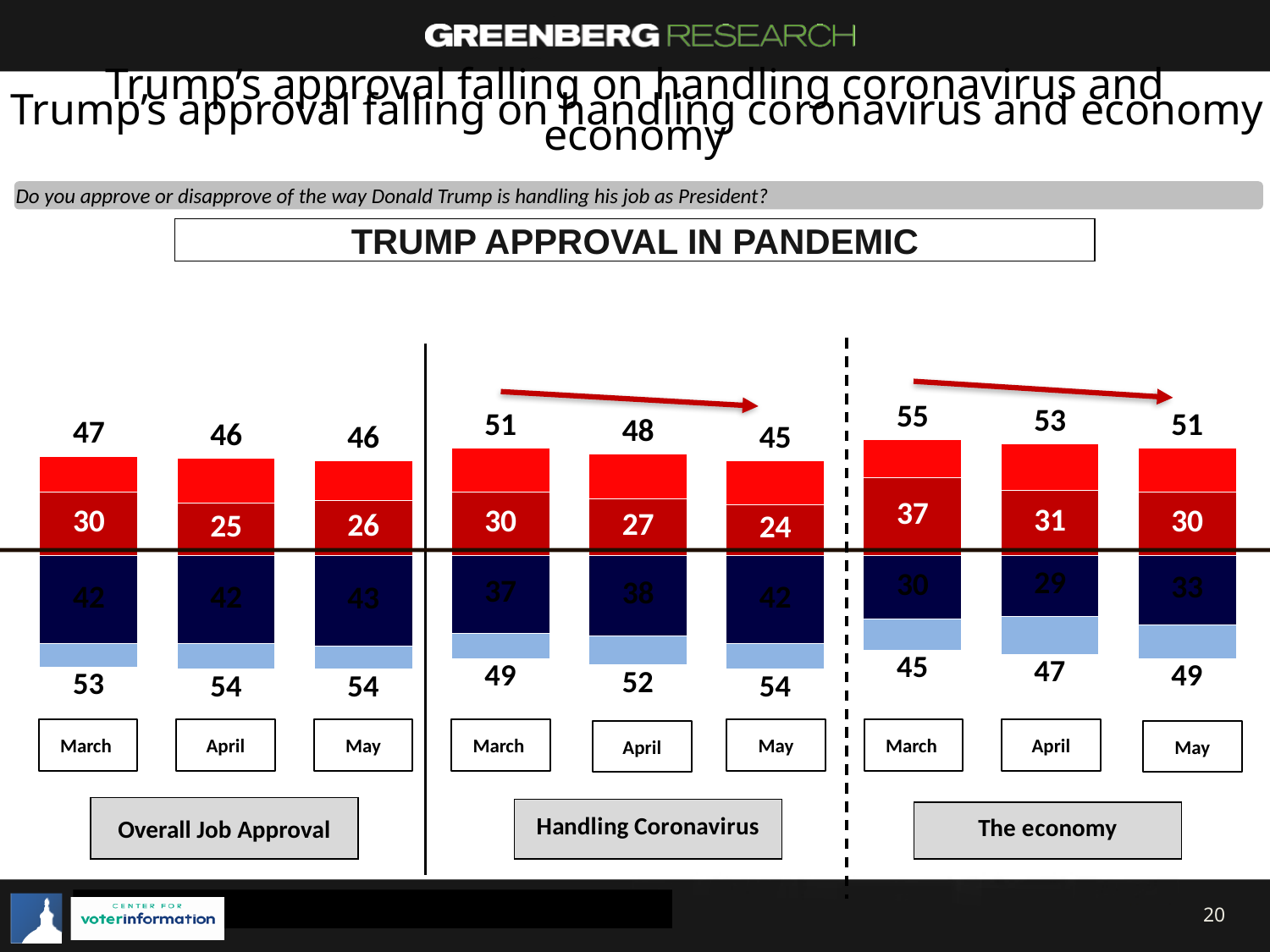
In The economy panel, is the value printed above the March bar larger or smaller than the value printed above the May bar? larger What is the title printed in the box above the chart? TRUMP APPROVAL IN PANDEMIC In the Handling Coronavirus panel, what value is printed above the May bar? 45 Do the values printed above the bars in the Handling Coronavirus panel rise or fall from March to May? fall In the Overall Job Approval panel, what value is printed above the March bar? 47 In the Handling Coronavirus panel, what value is printed in the bright red segment of the April bar? 27 In the Handling Coronavirus panel, which month has the lowest value printed above its bar? May In the Handling Coronavirus panel, what is the difference between the values printed above the March and May bars? 6 Across the three panels, which month and panel has the highest value printed above its bar? March, The economy In The economy panel, what value is printed in the bright red segment of the March bar? 37 How many months are shown in each panel of the chart? 3 In The economy panel, what value is printed below the April bar? 47